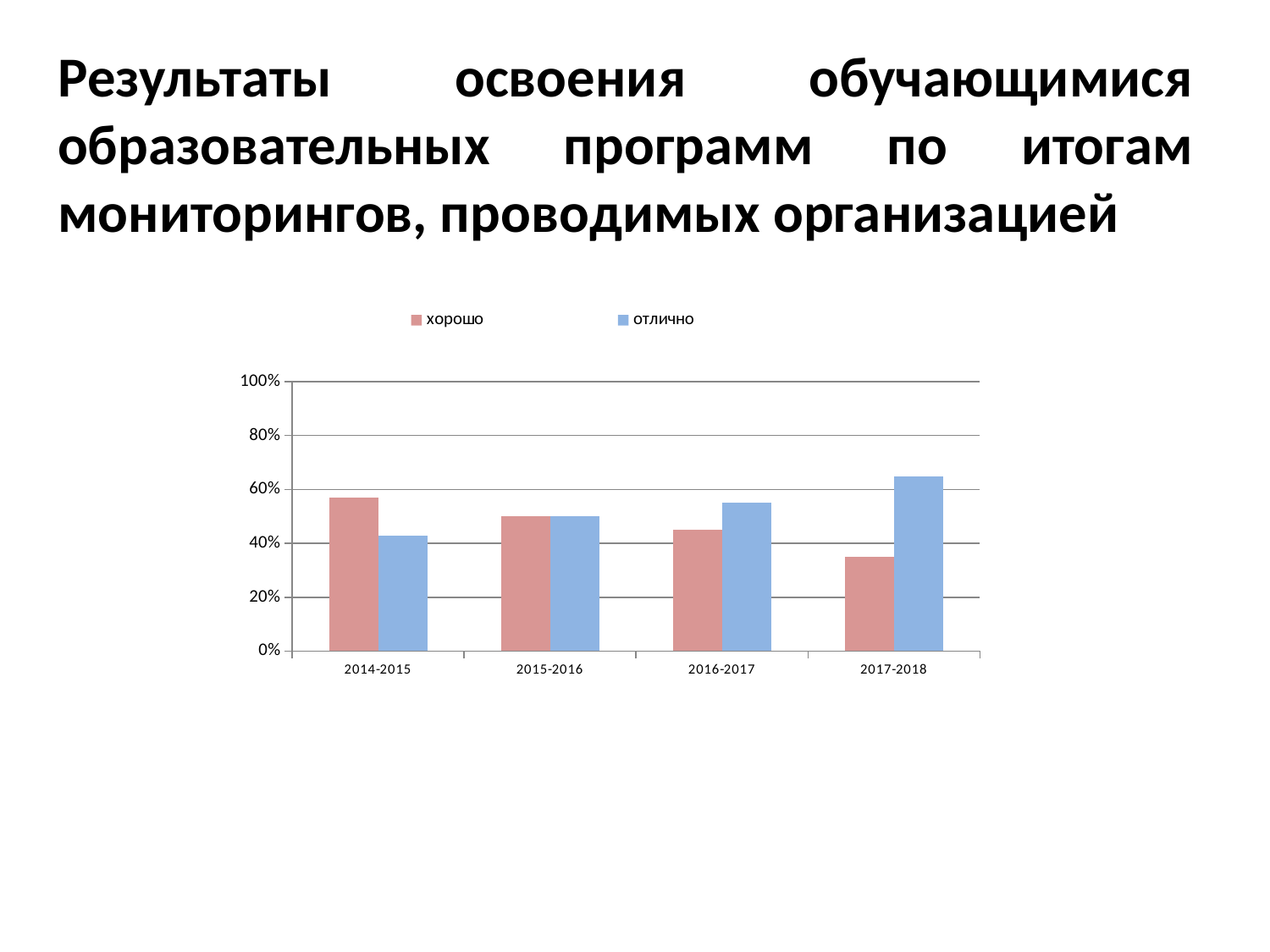
How many series does the legend list? 2 In 2017-2018, which is larger: хорошо or отлично? отлично Is the value for отлично in 2017-2018 greater or less than 60%? greater Do the values for хорошо rise or fall from 2014-2015 to 2017-2018? fall In 2014-2015, which is larger: хорошо or отлично? хорошо How many academic years are shown on the x axis? 4 Which year has the highest value for хорошо? 2014-2015 Which year has the highest value for отлично? 2017-2018 Do the values for отлично rise or fall from 2014-2015 to 2017-2018? rise What kind of chart is shown on the slide? bar chart Is the value for хорошо in 2017-2018 greater or less than 40%? less Which year has the lowest value for хорошо? 2017-2018